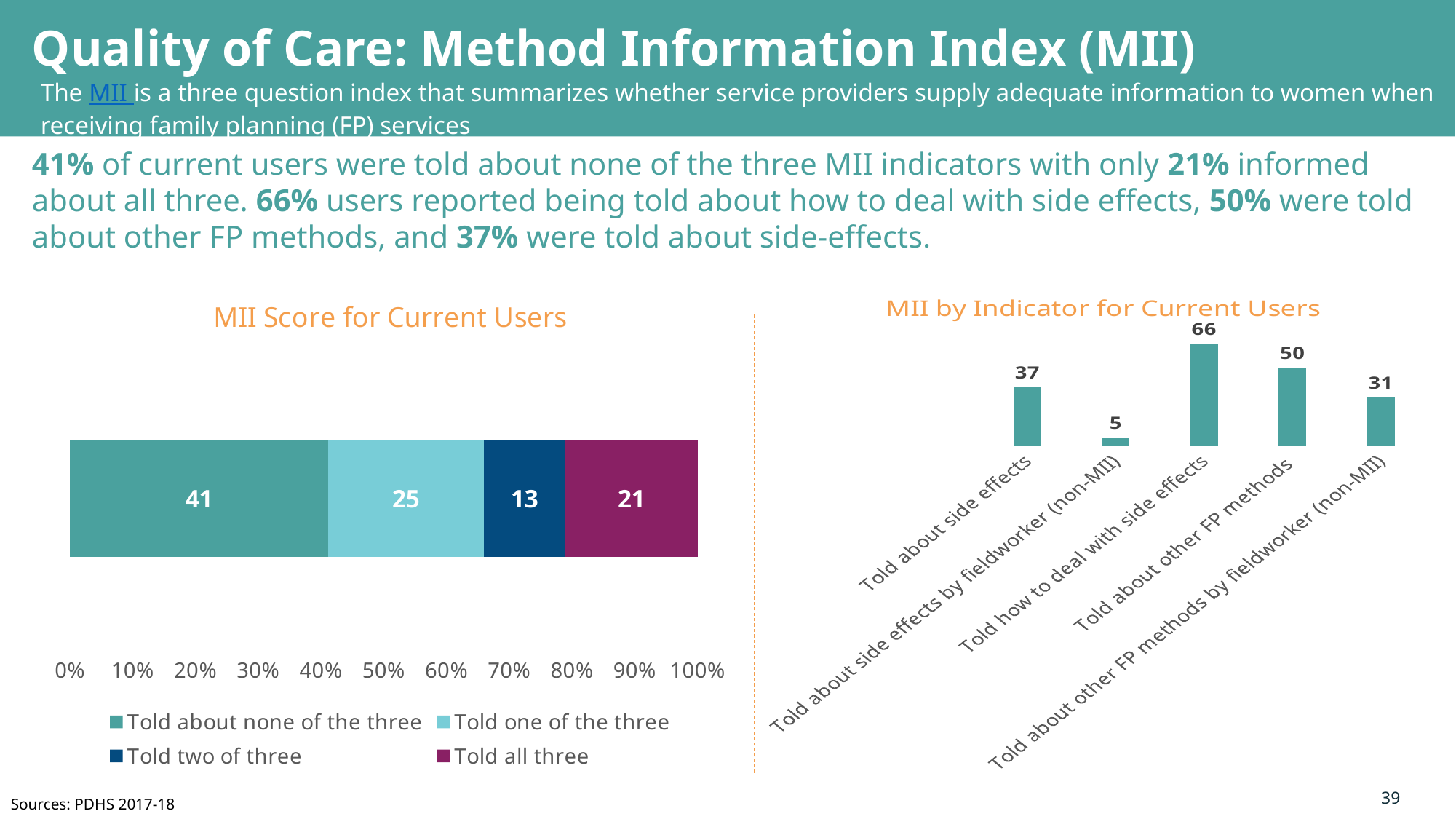
What kind of chart is 'MII by Indicator for Current Users'? Bar chart In the 'MII by Indicator for Current Users' chart, which is larger: 'Told about side effects' or 'Told about other FP methods'? Told about other FP methods In the 'MII by Indicator for Current Users' chart, what is the value for 'Told how to deal with side effects'? 66 In the 'MII by Indicator for Current Users' chart, which indicator has the highest value? Told how to deal with side effects In the 'MII Score for Current Users' chart, what is the value for 'Told all three'? 21 In the 'MII Score for Current Users' chart, what is the total of the stacked bar? 100 In the 'MII by Indicator for Current Users' chart, which indicator has the lowest value? Told about side effects by fieldworker (non-MII) In the 'MII Score for Current Users' chart, how many series does the legend list? 4 In the 'MII Score for Current Users' chart, what is the value for 'Told about none of the three'? 41 In the 'MII Score for Current Users' chart, which segment has the smallest value? Told two of three In the 'MII Score for Current Users' chart, what is the difference between 'Told about none of the three' and 'Told one of the three'? 16 In the 'MII by Indicator for Current Users' chart, how many indicators are shown? 5